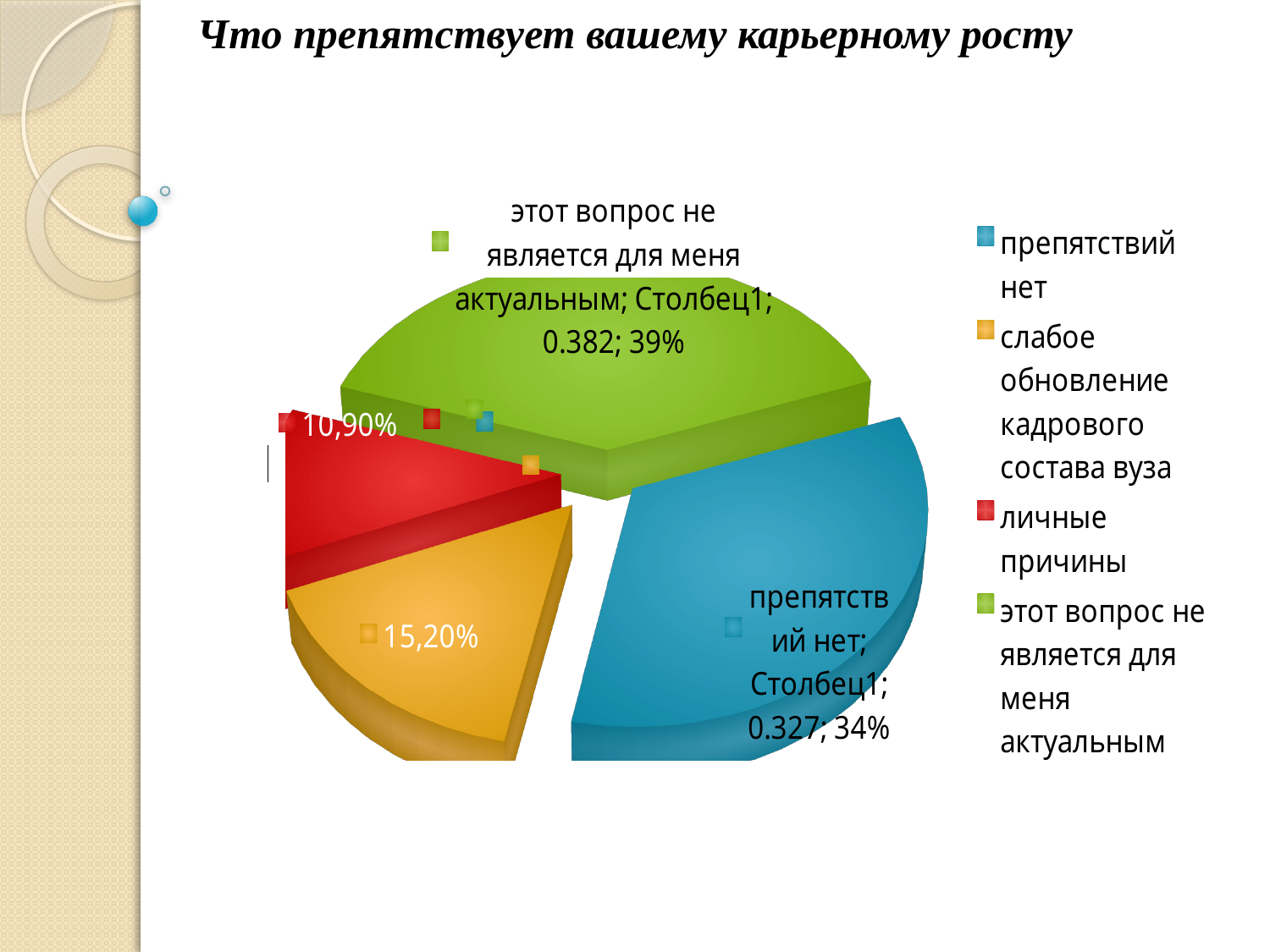
Which category has the smallest share of the pie? личные причины What value is printed on the yellow slice (слабое обновление кадрового состава вуза)? 15,20% How many entries does the legend list? 4 What percentage is shown for the slice "этот вопрос не является для меня актуальным"? 39% What value is printed on the red slice (личные причины)? 10,90% What percentage is shown for the slice "препятствий нет"? 34% How many slices does the pie chart have? 4 Which category has the largest share of the pie? этот вопрос не является для меня актуальным What kind of chart is shown on the slide? pie chart What is the title of the slide above the chart? Что препятствует вашему карьерному росту Which is larger: the share for "препятствий нет" or the share for "личные причины"? препятствий нет What is the difference in percentage points between the yellow slice (15,20%) and the red slice (10,90%)? 4,30%